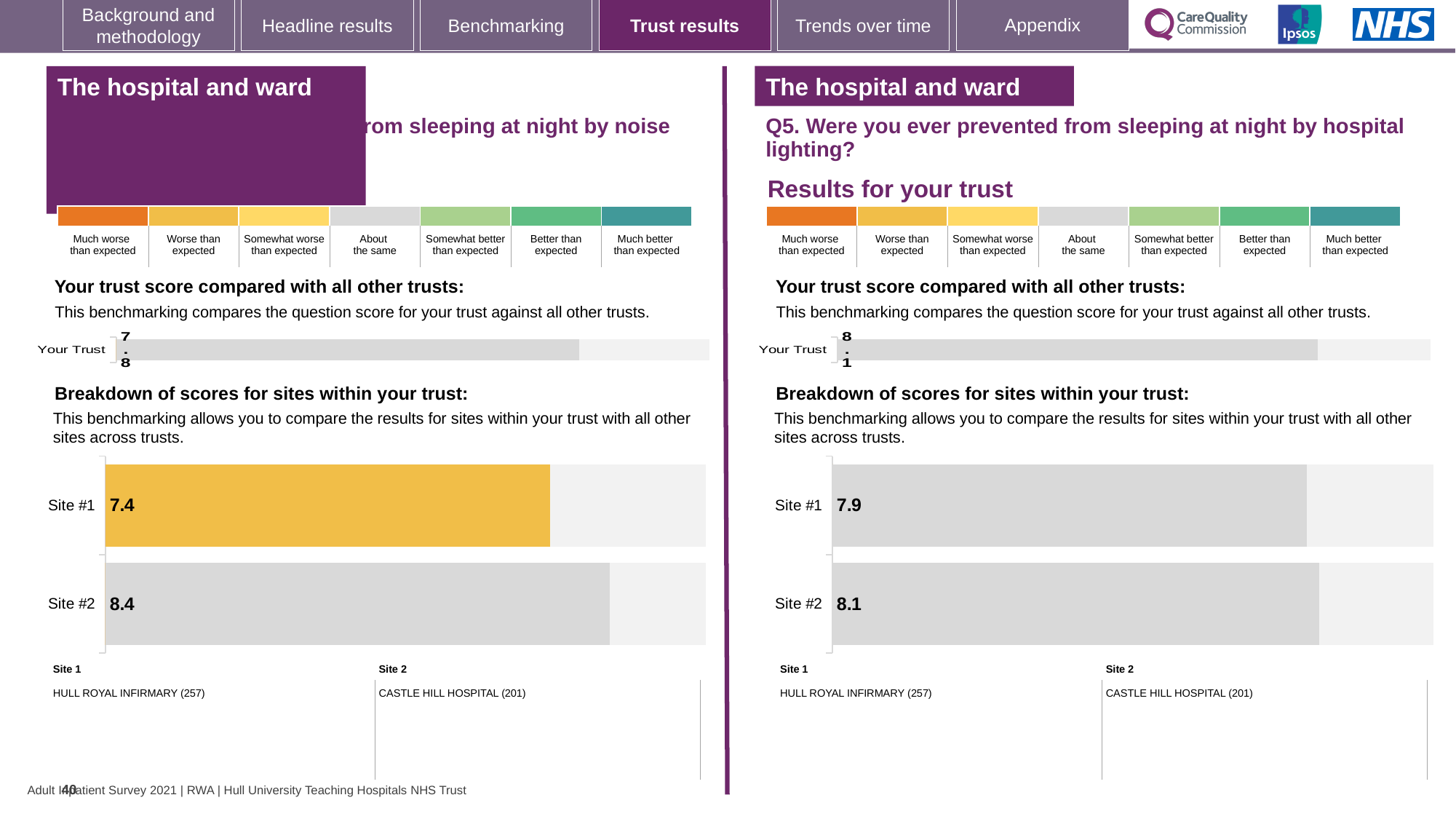
In the left-hand 'Your trust score compared with all other trusts' chart, what is the score for Your Trust? 7.8 In the left-hand site breakdown chart, which site's bar is coloured yellow? Site #1 In the Q5 (hospital lighting) site breakdown chart on the right, what is the score for Site #1? 7.9 How many sites are shown in the left-hand site breakdown chart? 2 In the left-hand site breakdown chart, what is the score for Site #2? 8.4 In the Q5 site breakdown chart on the right, which site has the lower score? Site #1 In the right-hand 'Your trust score compared with all other trusts' chart for Q5, what is the score for Your Trust? 8.1 In the Q5 site breakdown chart on the right, what is the difference between the Site #2 and Site #1 scores? 0.2 In the left-hand site breakdown chart, what is the score for Site #1? 7.4 In the left-hand site breakdown chart, which site has the higher score? Site #2 In the left-hand site breakdown chart, what is the difference between the Site #2 and Site #1 scores? 1.0 In the Q5 (hospital lighting) site breakdown chart on the right, what is the score for Site #2? 8.1